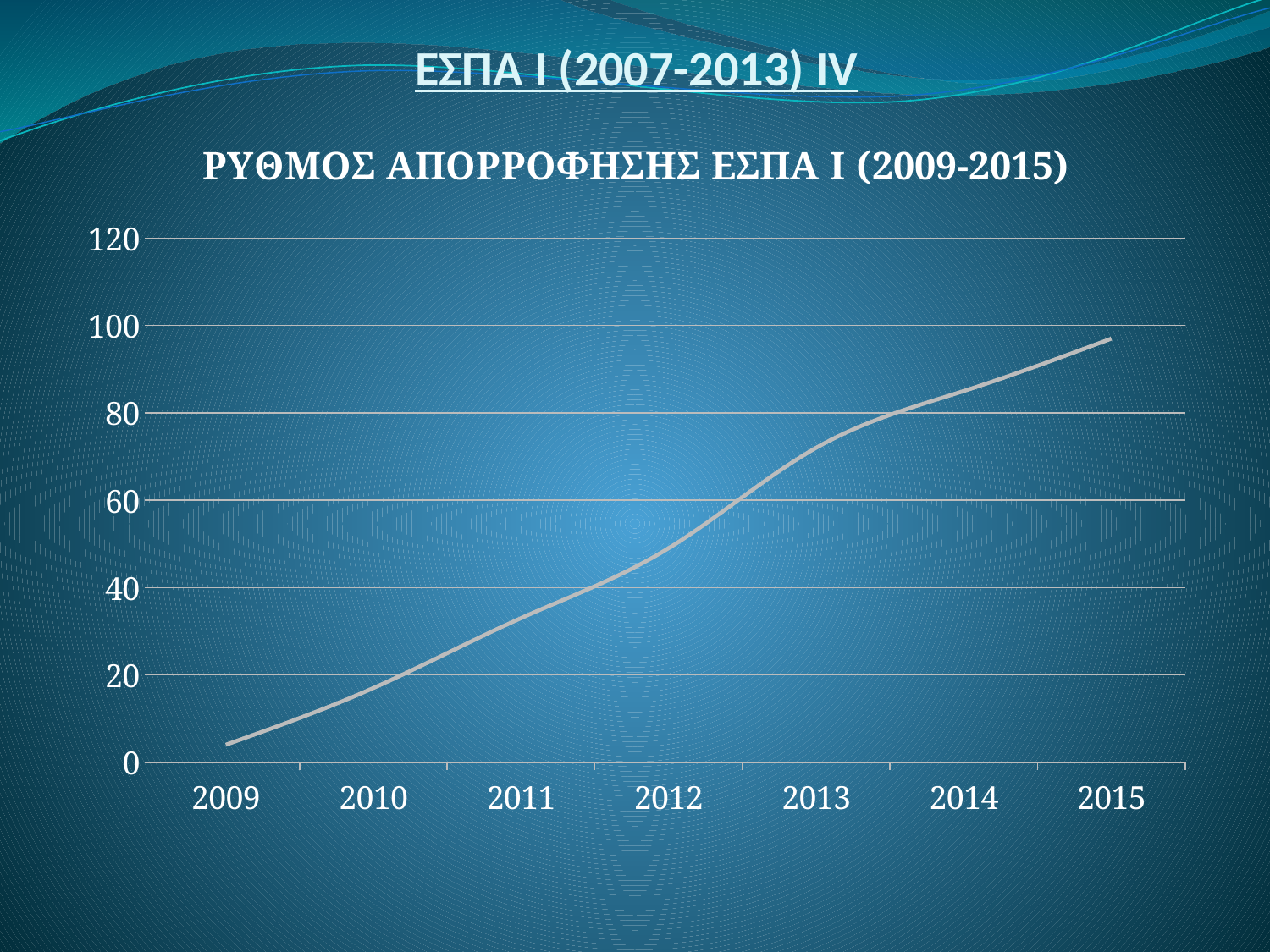
Which year has the larger value, 2011 or 2013? 2013 Is the value for 2009 greater or less than 20? less Do the values rise or fall from 2009 to 2015? rise Is the value for 2015 greater or less than 100? less What kind of chart is shown on the slide? line chart How many years are plotted on the x axis of the chart? 7 Which year has the lowest value on the chart? 2009 Which year has the highest value on the chart? 2015 Is the value for 2013 greater or less than 60? greater What is the title of the chart? ΡΥΘΜΟΣ ΑΠΟΡΡΟΦΗΣΗΣ ΕΣΠΑ Ι (2009-2015)